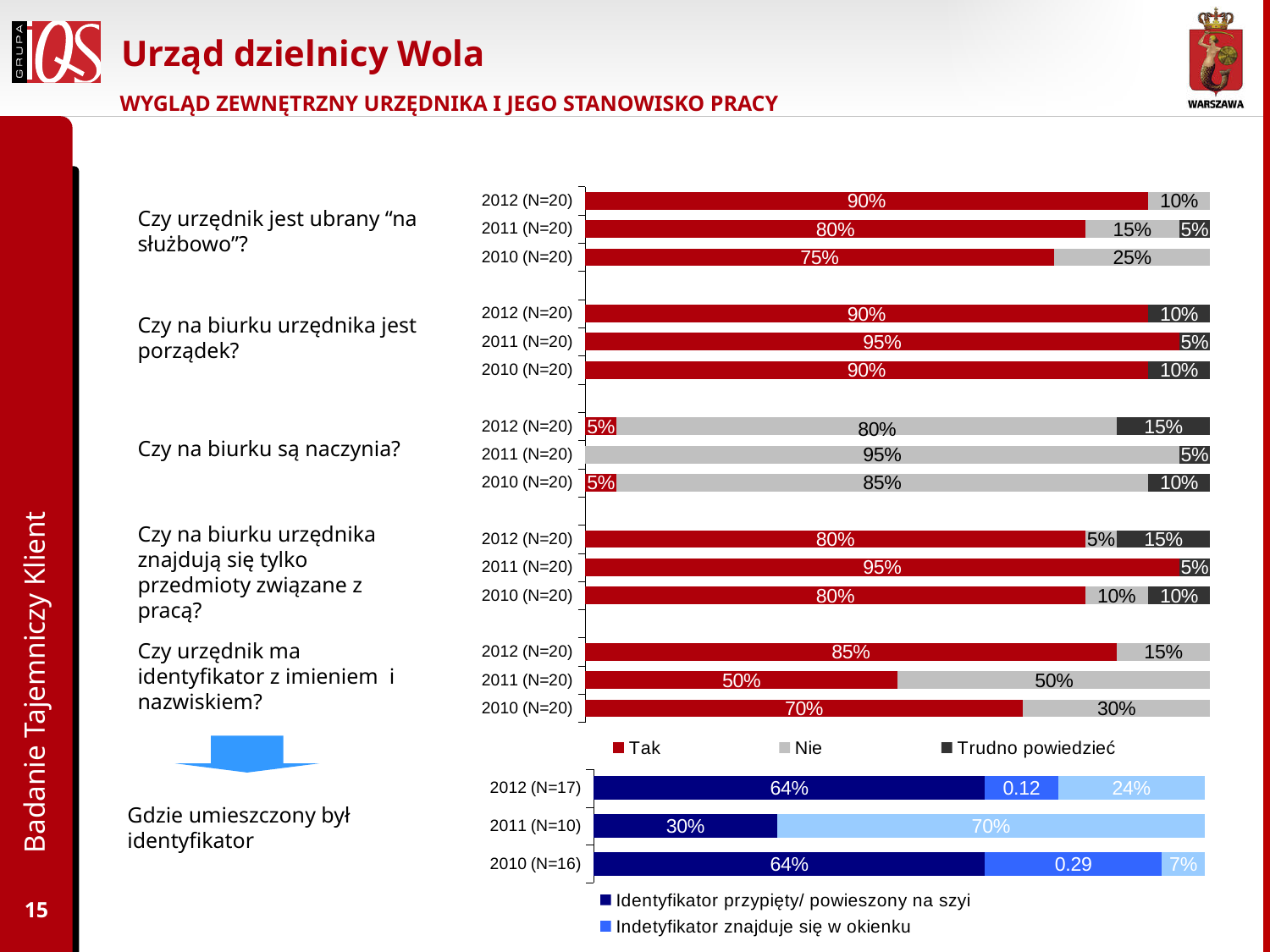
In the upper chart, what percentage answered "Tak" to "Czy urzędnik jest ubrany 'na służbowo'?" in 2012 (N=20)? 90% In the upper chart, for "Czy urzędnik ma identyfikator z imieniem i nazwiskiem?", which year has the lowest "Tak" share? 2011 (N=20) In the lower chart "Gdzie umieszczony był identyfikator", what is the value for "Indetyfikator znajduje się w okienku" in 2010 (N=16)? 0.29 In the upper chart, what percentage answered "Nie" to "Czy urzędnik jest ubrany 'na służbowo'?" in 2010 (N=20)? 25% How many series does the legend of the upper chart list? 3 In the upper chart, for "Czy na biurku urzędnika jest porządek?", which year has the highest "Tak" share? 2011 (N=20) In the lower chart "Gdzie umieszczony był identyfikator", what is the value for "Identyfikator przypięty/ powieszony na szyi" in 2011 (N=10)? 30% In the lower chart "Gdzie umieszczony był identyfikator", is the value for "Identyfikator przypięty/ powieszony na szyi" larger in 2012 (N=17) or in 2011 (N=10)? 2012 (N=17) In the upper chart, what percentage answered "Trudno powiedzieć" to "Czy na biurku urzędnika znajdują się tylko przedmioty związane z pracą?" in 2012 (N=20)? 15% In the upper chart, what percentage answered "Nie" to "Czy na biurku są naczynia?" in 2011 (N=20)? 95% In the upper chart, what is the difference between the "Tak" share for "Czy urzędnik ma identyfikator z imieniem i nazwiskiem?" in 2012 (N=20) and in 2010 (N=20)? 15 percentage points What type of chart is the upper chart? Stacked bar chart